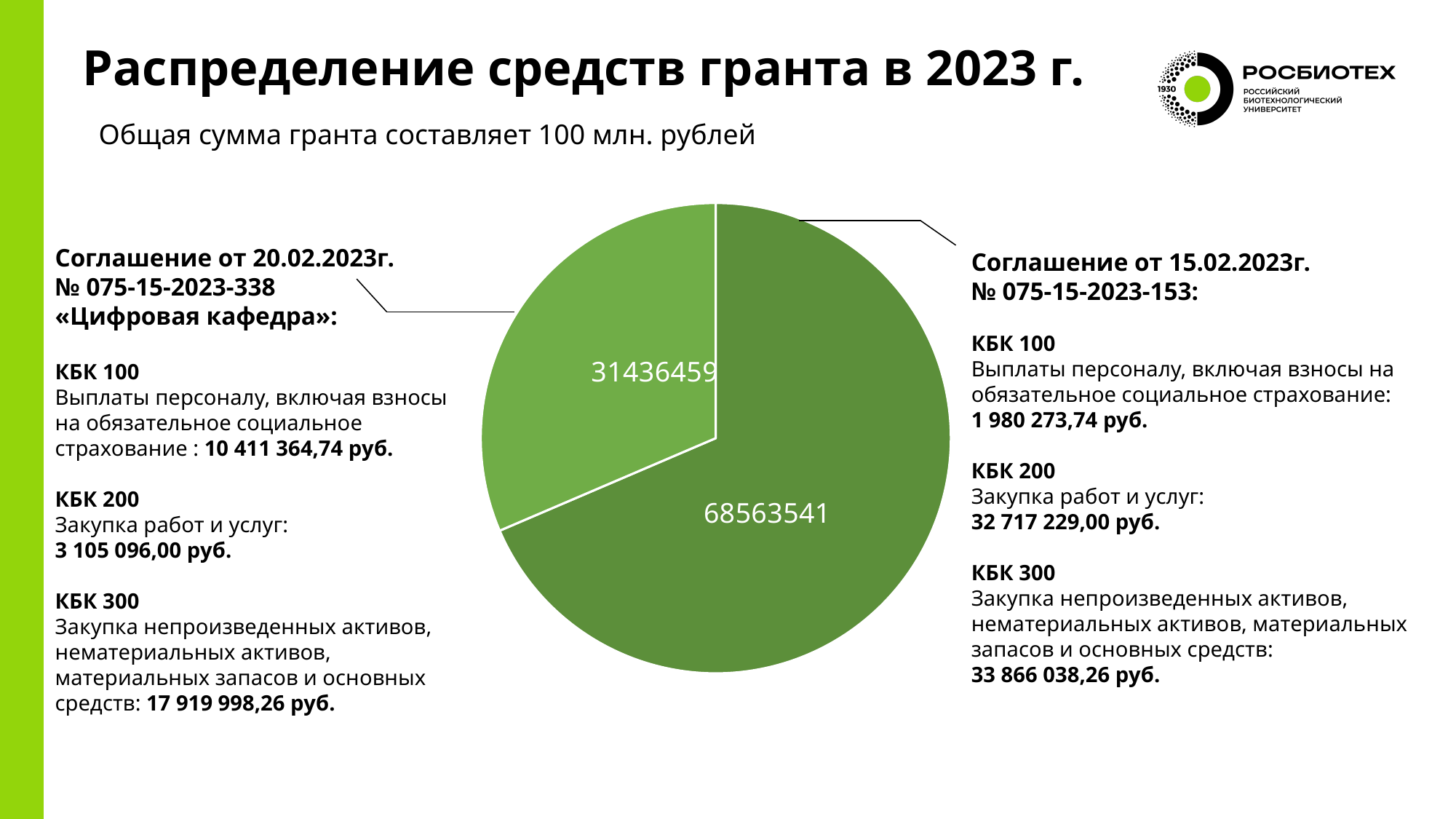
Which agreement has the larger slice of the pie chart? Соглашение от 15.02.2023г. № 075-15-2023-153 Which agreement has the smaller slice of the pie chart? Соглашение от 20.02.2023г. № 075-15-2023-338 «Цифровая кафедра» Which slice is shown in the darker green colour? 68563541 Is the value of the «Цифровая кафедра» slice greater or less than 50000000? less What is the total of the two slice values in the pie chart? 100000000 How many slices does the pie chart have? 2 What type of chart is shown on the slide? Pie chart What value is labelled on the slice for the agreement № 075-15-2023-338 «Цифровая кафедра»? 31436459 What value is labelled on the slice for the agreement № 075-15-2023-153? 68563541 What is the difference between the two slice values in the pie chart? 37127082 Is the slice labelled 31436459 larger or smaller than the slice labelled 68563541? Smaller What is the title of the slide containing the pie chart? Распределение средств гранта в 2023 г.